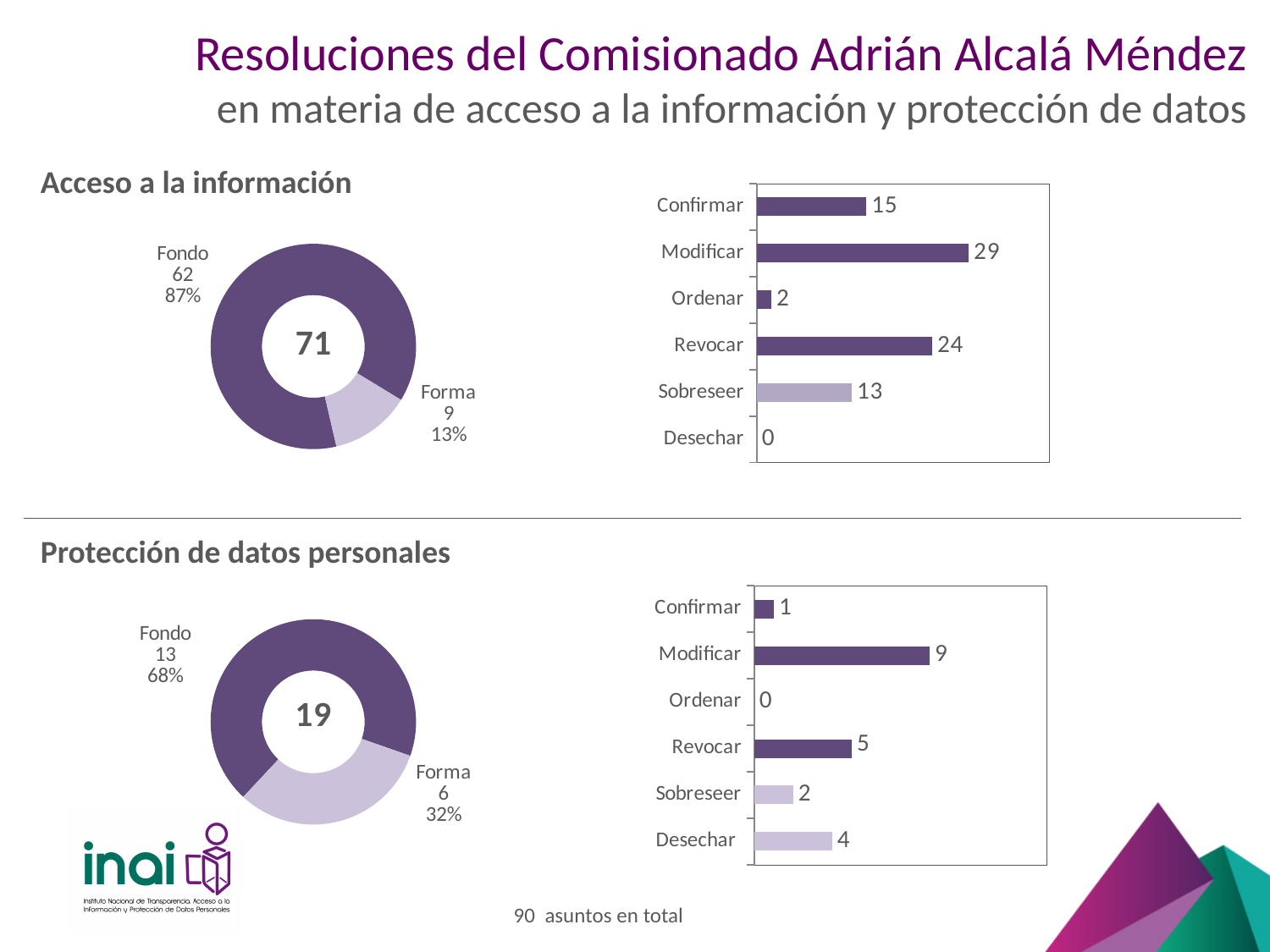
In the 'Acceso a la información' bar chart, which category has the highest value? Modificar In the 'Acceso a la información' bar chart, what is the difference between Modificar and Revocar? 5 In the 'Acceso a la información' bar chart, what is the value for Modificar? 29 What kind of chart is used on the right side of the 'Acceso a la información' section? Bar chart In the 'Protección de datos personales' bar chart, what is the value for Desechar? 4 In the 'Protección de datos personales' bar chart, which is larger, Revocar or Sobreseer? Revocar In the 'Acceso a la información' bar chart, which category has the lowest value? Desechar In the 'Protección de datos personales' donut chart, what share does Fondo represent? 68% In the 'Acceso a la información' donut chart, what is the value for Fondo? 62 In the 'Protección de datos personales' donut chart, what is the total shown in the centre? 19 How many categories does the 'Protección de datos personales' bar chart show? 6 In the 'Acceso a la información' donut chart, what share does Forma represent? 13%